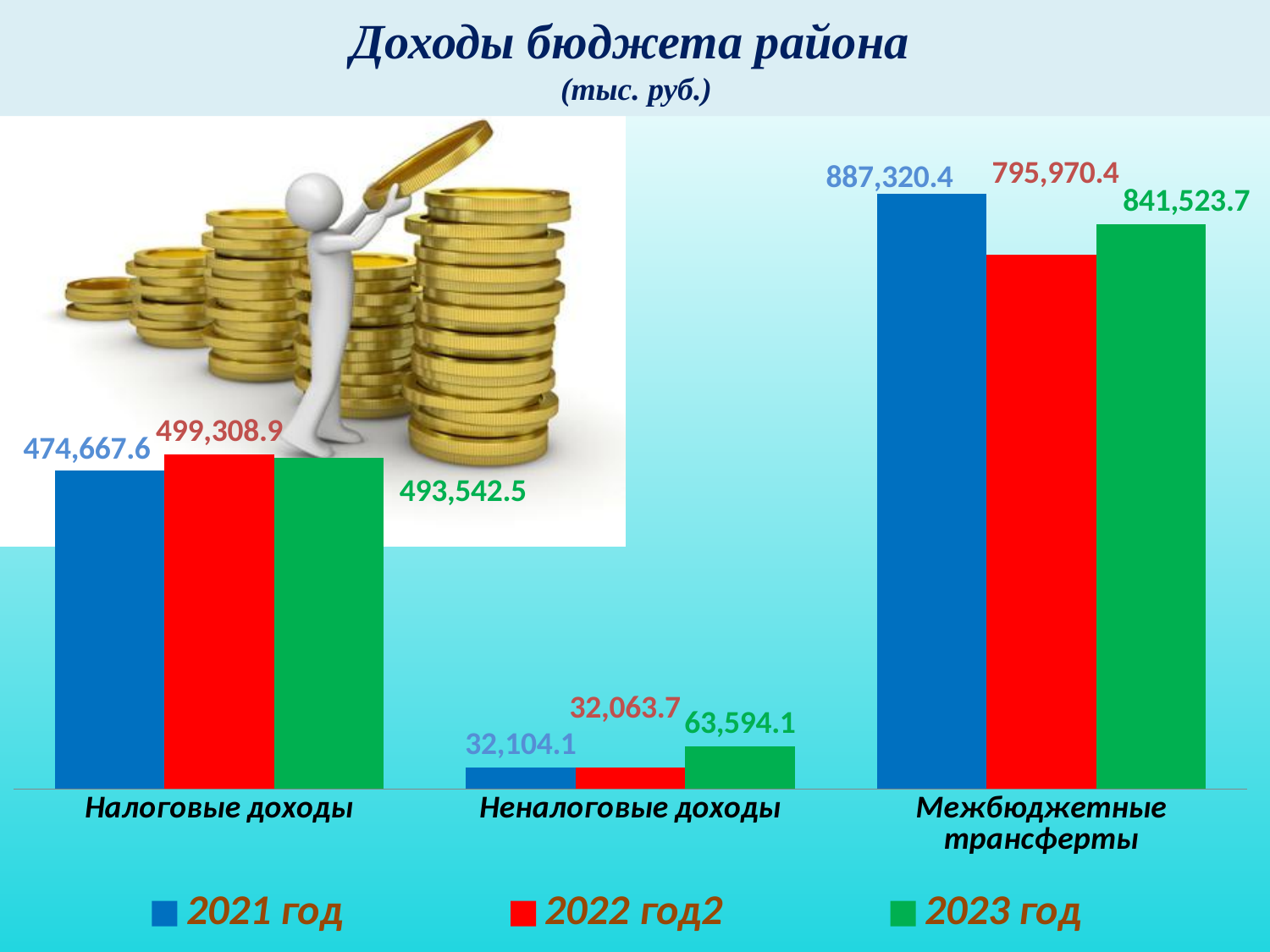
Which category has the lowest value in 2023 год? Неналоговые доходы Which category has the highest value in 2021 год? Межбюджетные трансферты What is the difference between the 2021 год and 2022 год2 values for Межбюджетные трансферты? 91,350.0 What kind of chart is shown on the slide? Bar chart What is the title of the chart? Доходы бюджета района (тыс. руб.) How many categories are shown on the x axis? 3 What is the value for Межбюджетные трансферты in 2023 год? 841,523.7 What is the value for Неналоговые доходы in 2022 год2? 32,063.7 How many series does the legend list? 3 Which is larger for Межбюджетные трансферты: the 2021 год value or the 2023 год value? 2021 год What is the value for Налоговые доходы in 2021 год? 474,667.6 What is the difference between the 2023 год and 2021 год values for Неналоговые доходы? 31,490.0